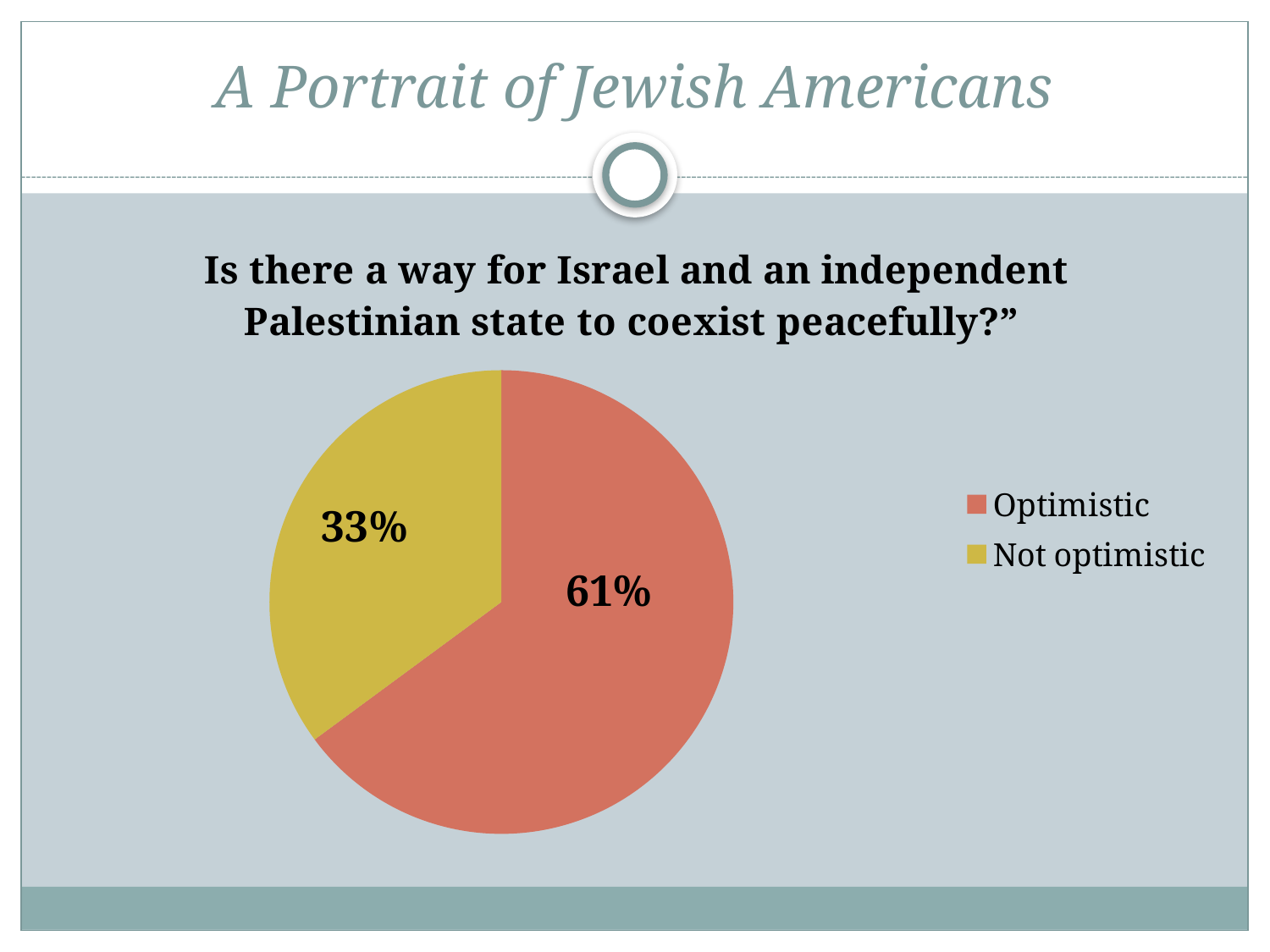
What colour is the Not optimistic slice? yellow Which slice of the pie is the largest? Optimistic What percentage of respondents are Optimistic? 61% Which slice of the pie is the smallest? Not optimistic Which is larger, the Optimistic slice or the Not optimistic slice? Optimistic What percentage of respondents are Not optimistic? 33% What question does the chart title ask? Is there a way for Israel and an independent Palestinian state to coexist peacefully? How many slices does the pie chart have? 2 What kind of chart is shown on the slide? pie chart What share of the pie does the Optimistic slice represent? 61% How many entries does the legend list? 2 What is the difference in percentage points between the Optimistic and Not optimistic slices? 28